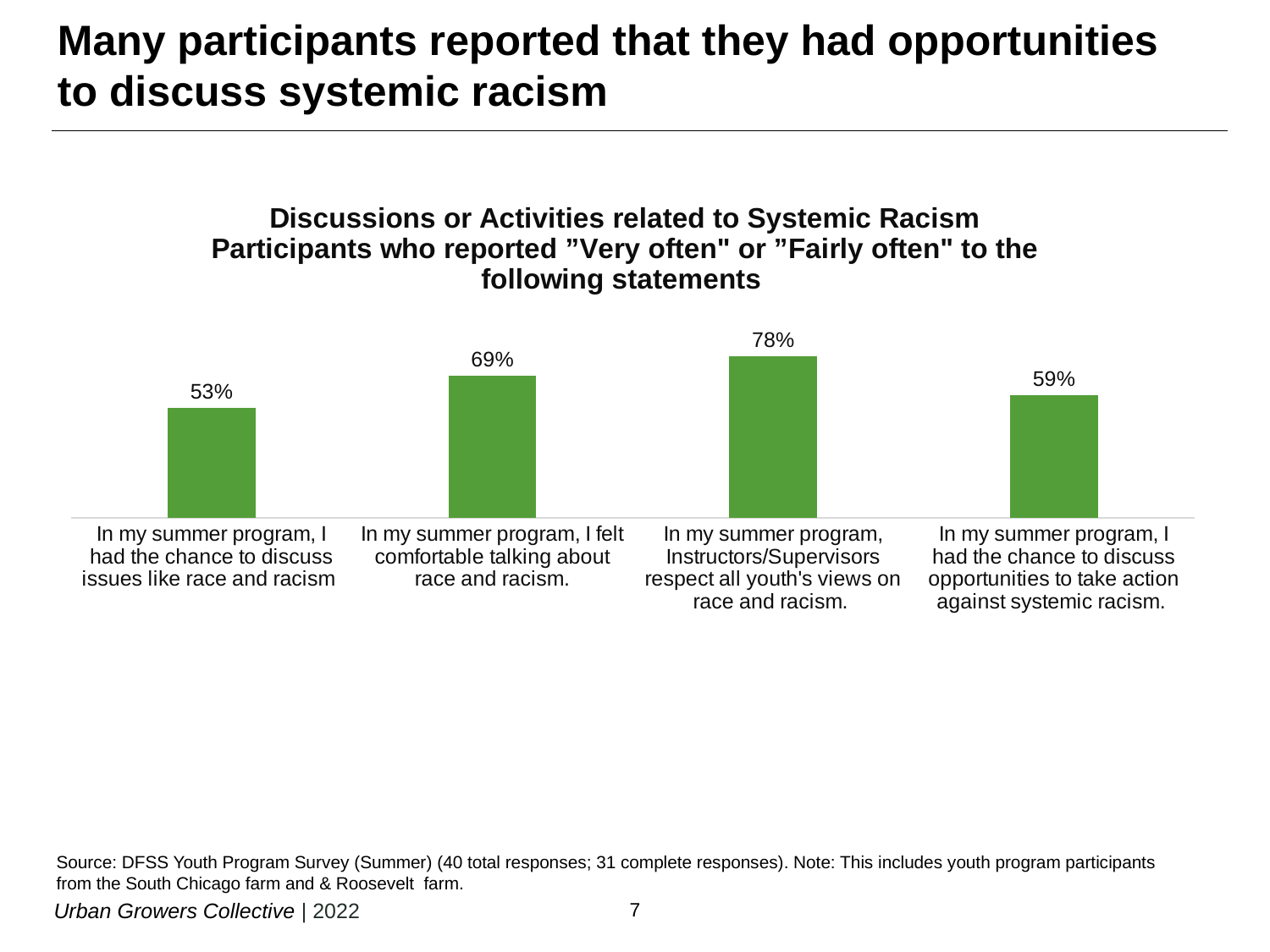
What kind of chart is shown on the slide? Bar chart What is the value for "In my summer program, I felt comfortable talking about race and racism."? 69% What is the value for "In my summer program, I had the chance to discuss opportunities to take action against systemic racism."? 59% What is the value for "In my summer program, Instructors/Supervisors respect all youth's views on race and racism."? 78% Which statement has the highest percentage of participants reporting "Very often" or "Fairly often"? In my summer program, Instructors/Supervisors respect all youth's views on race and racism. What colour are the bars in the chart? Green Which statement has the lowest percentage? In my summer program, I had the chance to discuss issues like race and racism What percentage of participants reported "Very often" or "Fairly often" for "In my summer program, I had the chance to discuss issues like race and racism"? 53% How many statements (bars) are shown in the chart? 4 Which is larger: the value for "I had the chance to discuss issues like race and racism" or the value for "I had the chance to discuss opportunities to take action against systemic racism"? I had the chance to discuss opportunities to take action against systemic racism What is the difference in percentage points between the highest and lowest bars? 25 What is the difference between the value for "I felt comfortable talking about race and racism" and the value for "I had the chance to discuss opportunities to take action against systemic racism"? 10